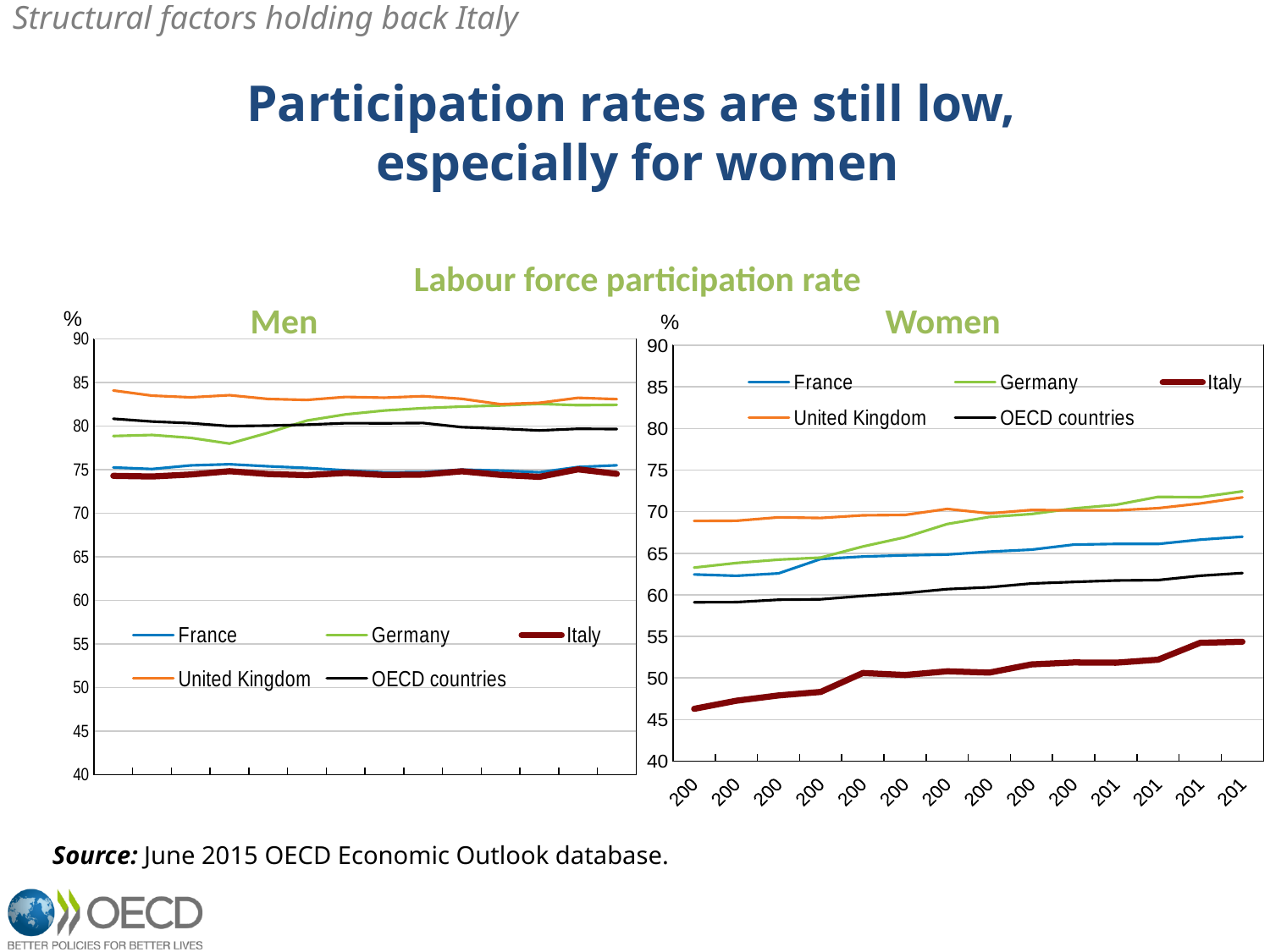
In the Men chart, which series has the highest participation rate across the period? United Kingdom What kind of chart is the Men chart? line chart In the Women chart, does the Italy line rise or fall along the x axis? rise In the Women chart, is the value for OECD countries greater or less than 65 throughout the period? less In the Women chart, which is higher, France or OECD countries? France In the Women chart, which series has the lowest participation rate across the period? Italy In the Men chart, is the value for Italy greater or less than 80? less In the Men chart, which is higher, United Kingdom or Germany? United Kingdom How many series does the legend of the Women chart list? 5 In the Men chart, does the Germany line rise or fall overall along the x axis? rise In the Women chart, is the value for Italy greater or less than 60 throughout the period? less What is the overall title shown above the two charts? Labour force participation rate